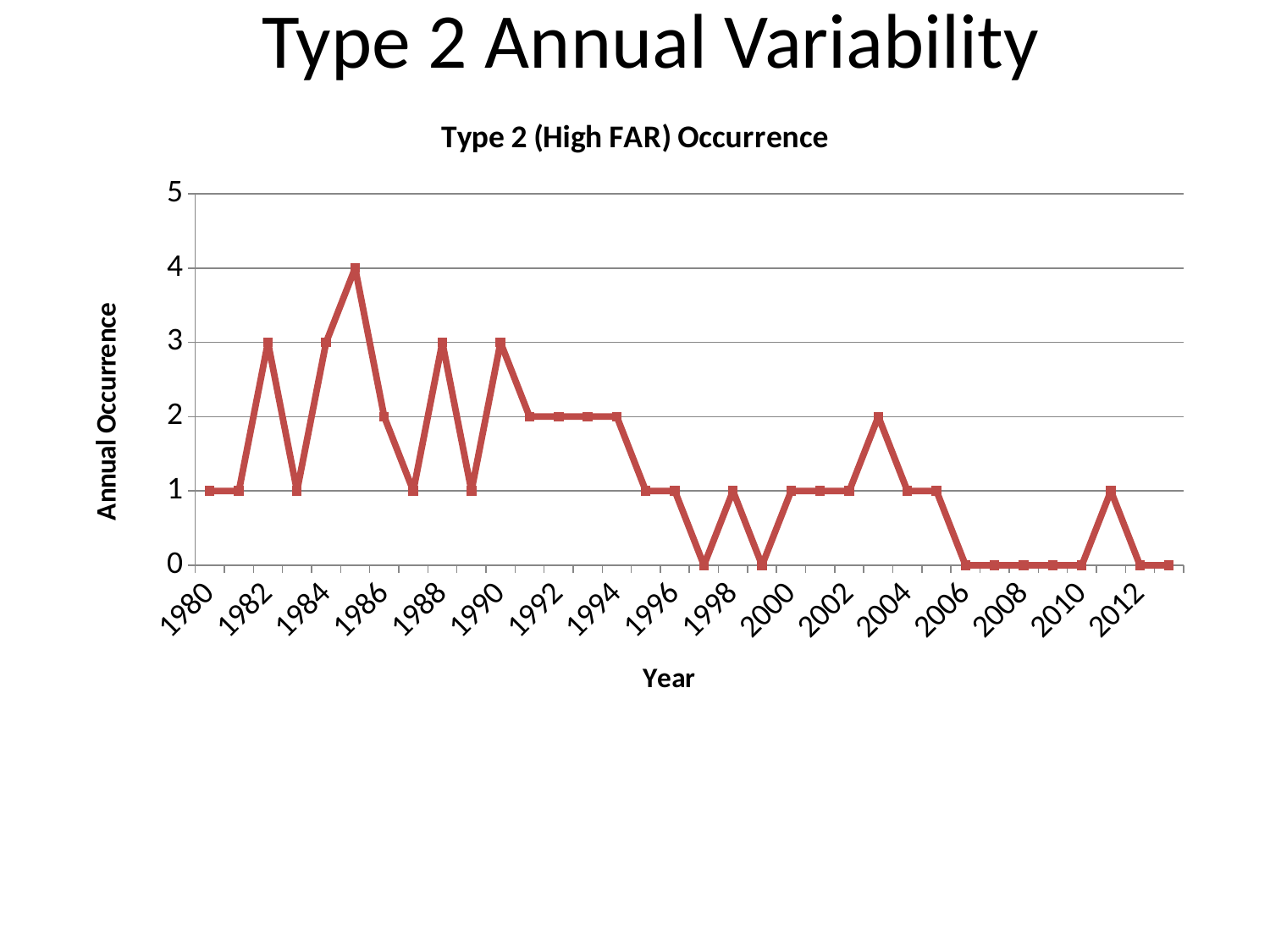
Overall, do the values rise or fall from 1980 to 2012? fall What kind of chart is shown on the slide? line chart What is the annual occurrence for 1992? 2 What is the title of the chart? Type 2 (High FAR) Occurrence Which year has the highest annual occurrence? 1985 Which year has a higher annual occurrence, 1990 or 2003? 1990 What is the annual occurrence for 1985? 4 What is the lowest annual occurrence value plotted on the chart? 0 What is the annual occurrence for 1982? 3 What is the annual occurrence for 2008? 0 What is the label of the y axis? Annual Occurrence What is the difference between the annual occurrence in 1985 and in 1986? 2